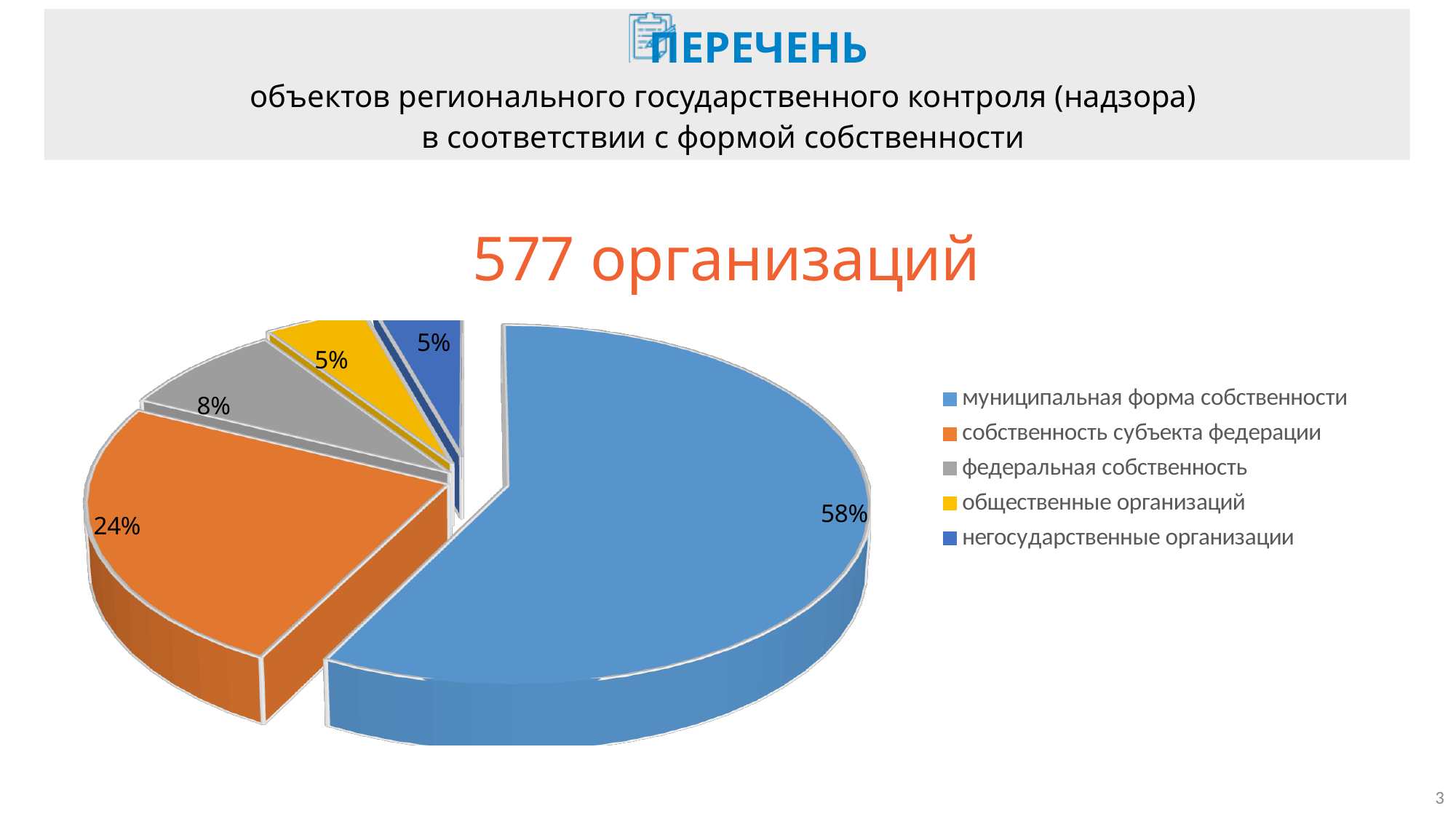
What share of the pie does общественные организаций have? 5% Which category has the largest slice of the pie? муниципальная форма собственности What is the difference in percentage points between муниципальная форма собственности and собственность субъекта федерации? 34 What share of the pie does собственность субъекта федерации have? 24% What share of the pie does муниципальная форма собственности have? 58% How many categories does the legend list? 5 What kind of chart is shown on the slide? pie chart What total number of organisations is stated above the chart? 577 организаций Which is larger, the share for собственность субъекта федерации or the share for федеральная собственность? собственность субъекта федерации What colour is the slice for федеральная собственность? grey What is the combined share of общественные организаций and негосударственные организации? 10%